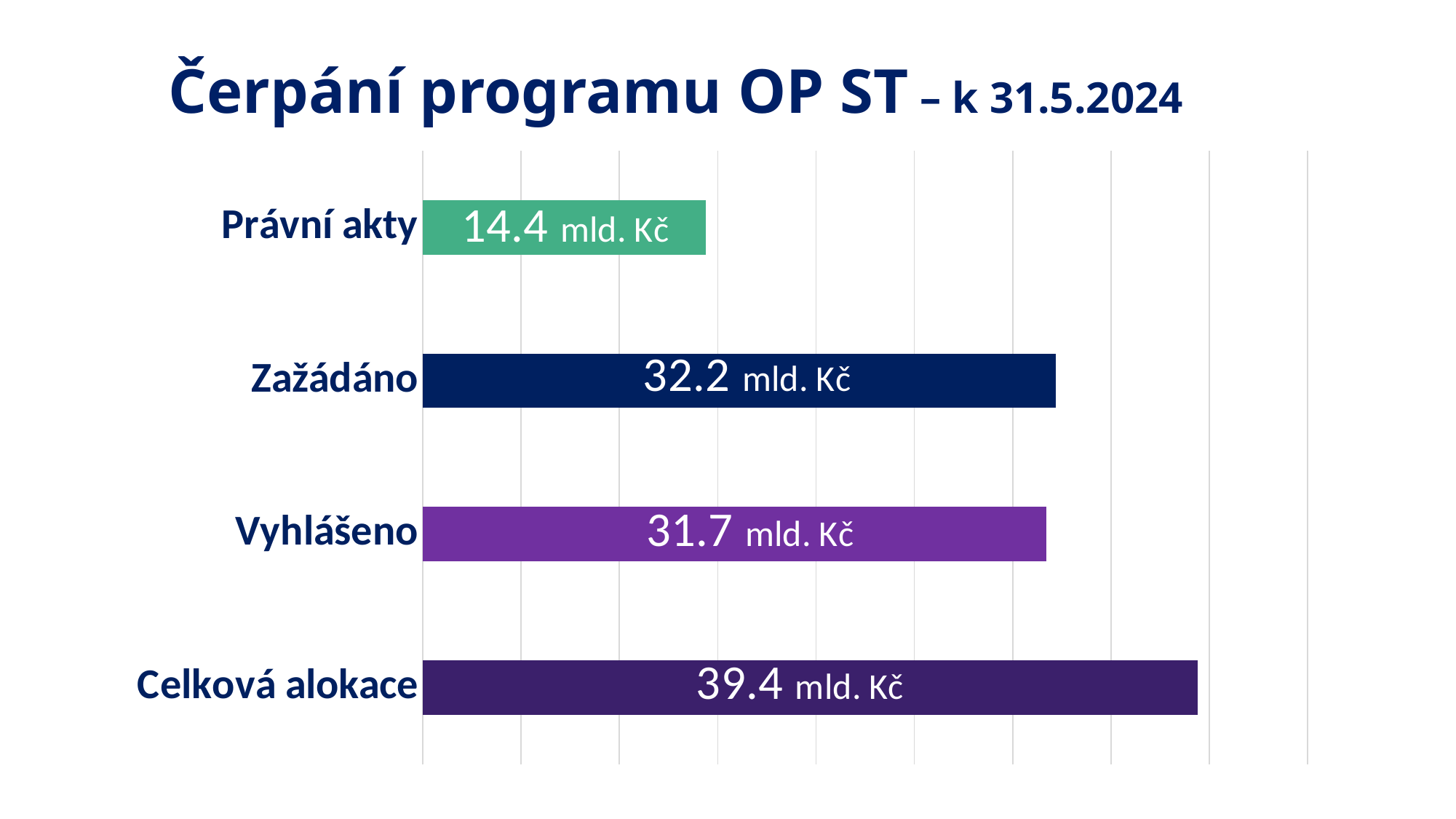
Which category has the highest value? Celková alokace What is the difference between Celková alokace and Zažádáno? 7.2 mld. Kč What kind of chart is shown on the slide? Bar chart Which is larger, Zažádáno or Vyhlášeno? Zažádáno What is the title of the chart? Čerpání programu OP ST – k 31.5.2024 What is the value for Celková alokace? 39.4 mld. Kč Which category has the lowest value? Právní akty How many categories are shown in the chart? 4 What is the value for Právní akty? 14.4 mld. Kč What is the value for Zažádáno? 32.2 mld. Kč What is the difference between Zažádáno and Právní akty? 17.8 mld. Kč What is the value for Vyhlášeno? 31.7 mld. Kč